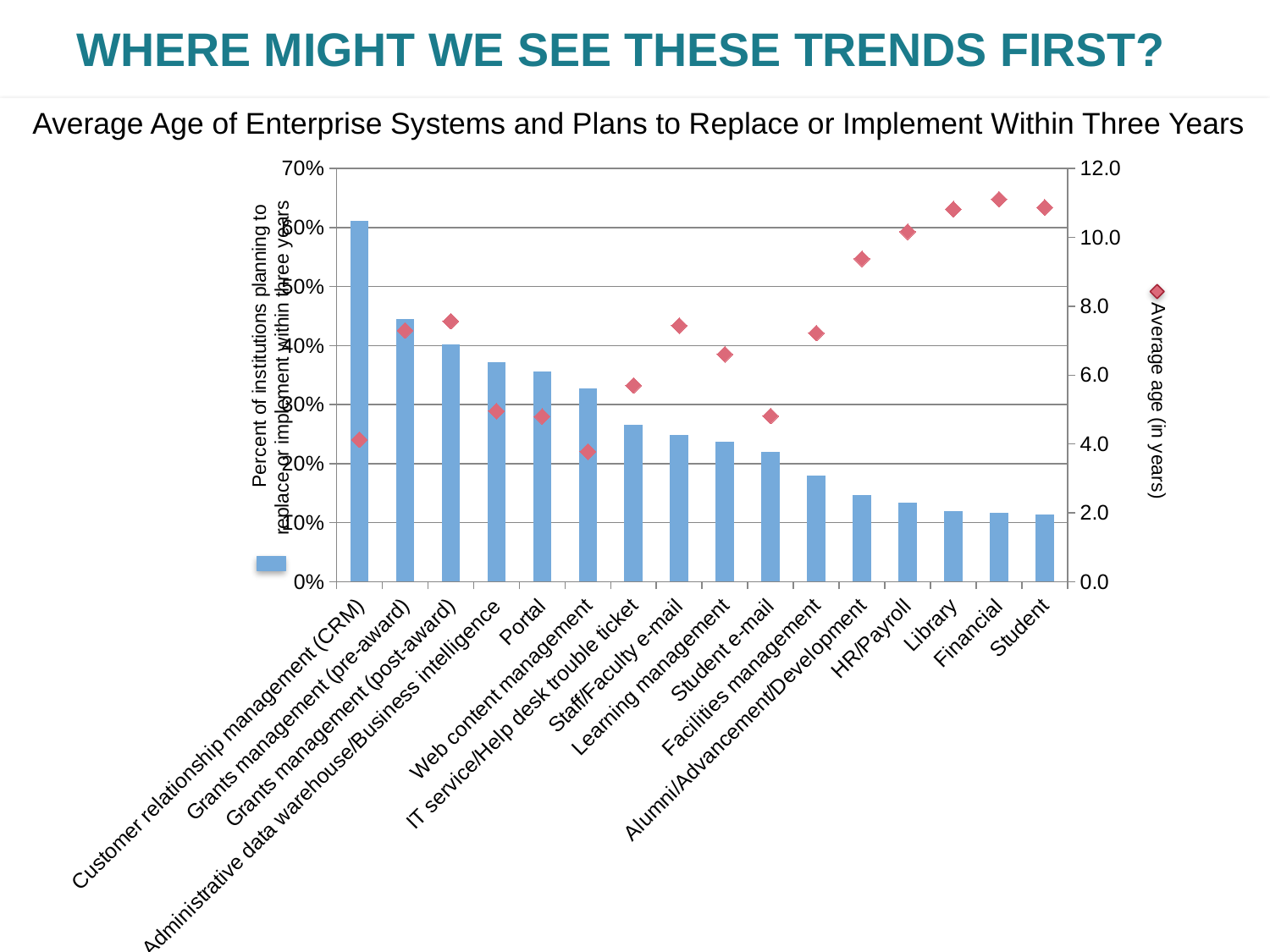
What kind of chart is this? Bar chart with a diamond-marker series Is the bar value for Customer relationship management (CRM) greater or less than 50%? greater Is the average age (diamond marker) for Portal greater or less than 6.0 years? less Which has a larger bar value, Customer relationship management (CRM) or Student? Customer relationship management (CRM) How many categories are shown on the x axis? 16 Is the bar value for Student greater or less than 20%? less Which has a higher average age, Financial or Customer relationship management (CRM)? Financial Which category has the tallest bar (highest percent of institutions planning to replace or implement)? Customer relationship management (CRM) Do the bar values rise or fall moving from left to right along the x axis? fall What is the title of the chart? Average Age of Enterprise Systems and Plans to Replace or Implement Within Three Years